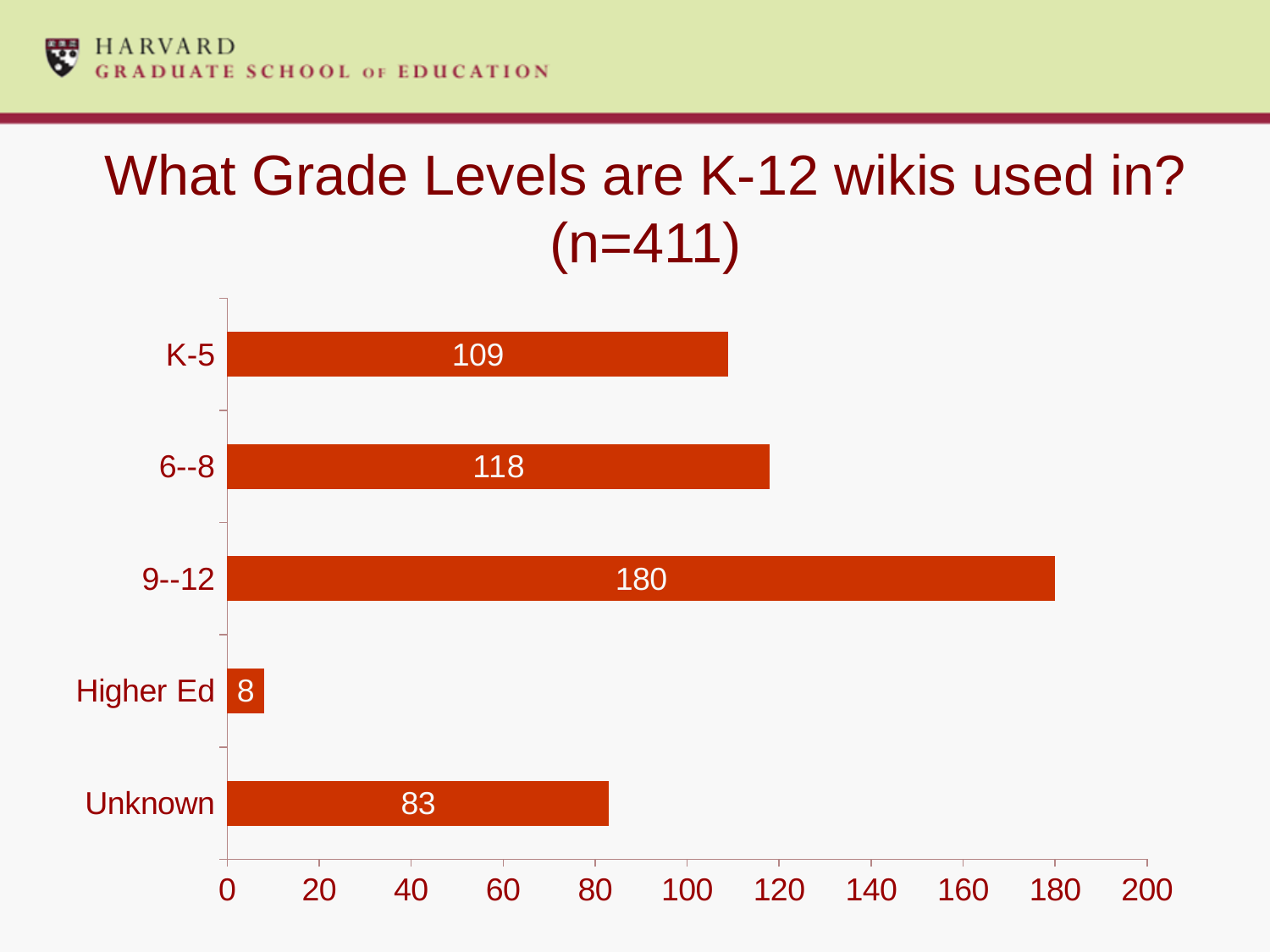
Which is larger, the value for K-5 or the value for 6--8? 6--8 What kind of chart is shown on the slide? bar chart What is the value for 9--12? 180 What is the value for Higher Ed? 8 How many categories are shown in the chart? 5 Which category has the lowest value? Higher Ed What is the value for K-5? 109 What is the difference between the values for 9--12 and 6--8? 62 Which grade level has the highest value? 9--12 Is the value for Unknown greater or less than 100? less What is the title of the chart? What Grade Levels are K-12 wikis used in? (n=411) What is the value for Unknown? 83